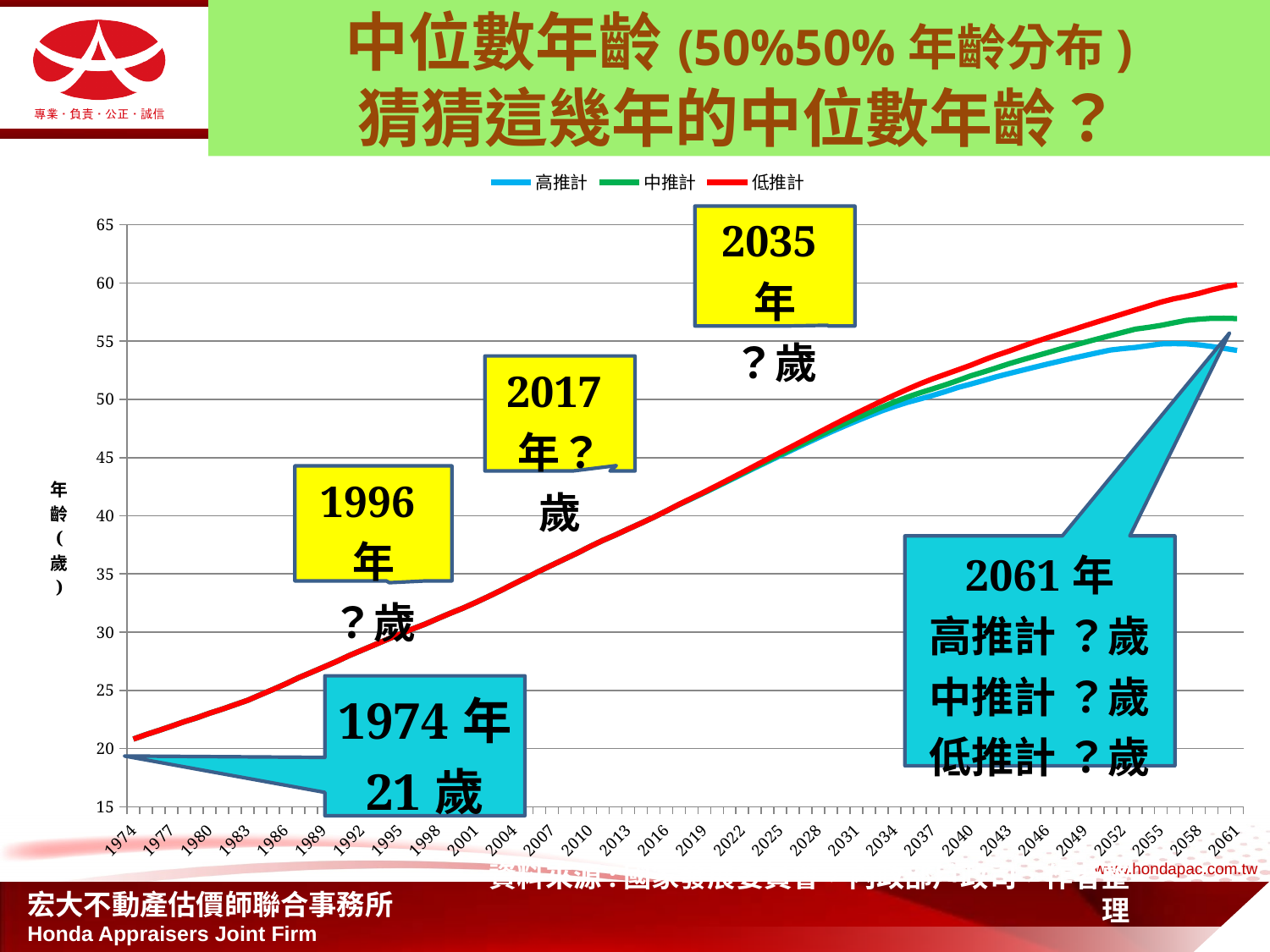
Is the value for 2017 greater or less than 35? greater How many series does the legend list? 3 Is the 高推計 value for 2061 greater or less than 50? greater Which series has the highest value in 2061? 低推計 What is the median age shown for 1974? 21 歲 In 2061, which is larger: 低推計 or 高推計? 低推計 Does the median age rise or fall from 1974 to 2035? rise Is the value for 2035 greater or less than 45? greater What are the three series named in the legend? 高推計, 中推計, 低推計 What kind of chart is shown on the slide? line chart